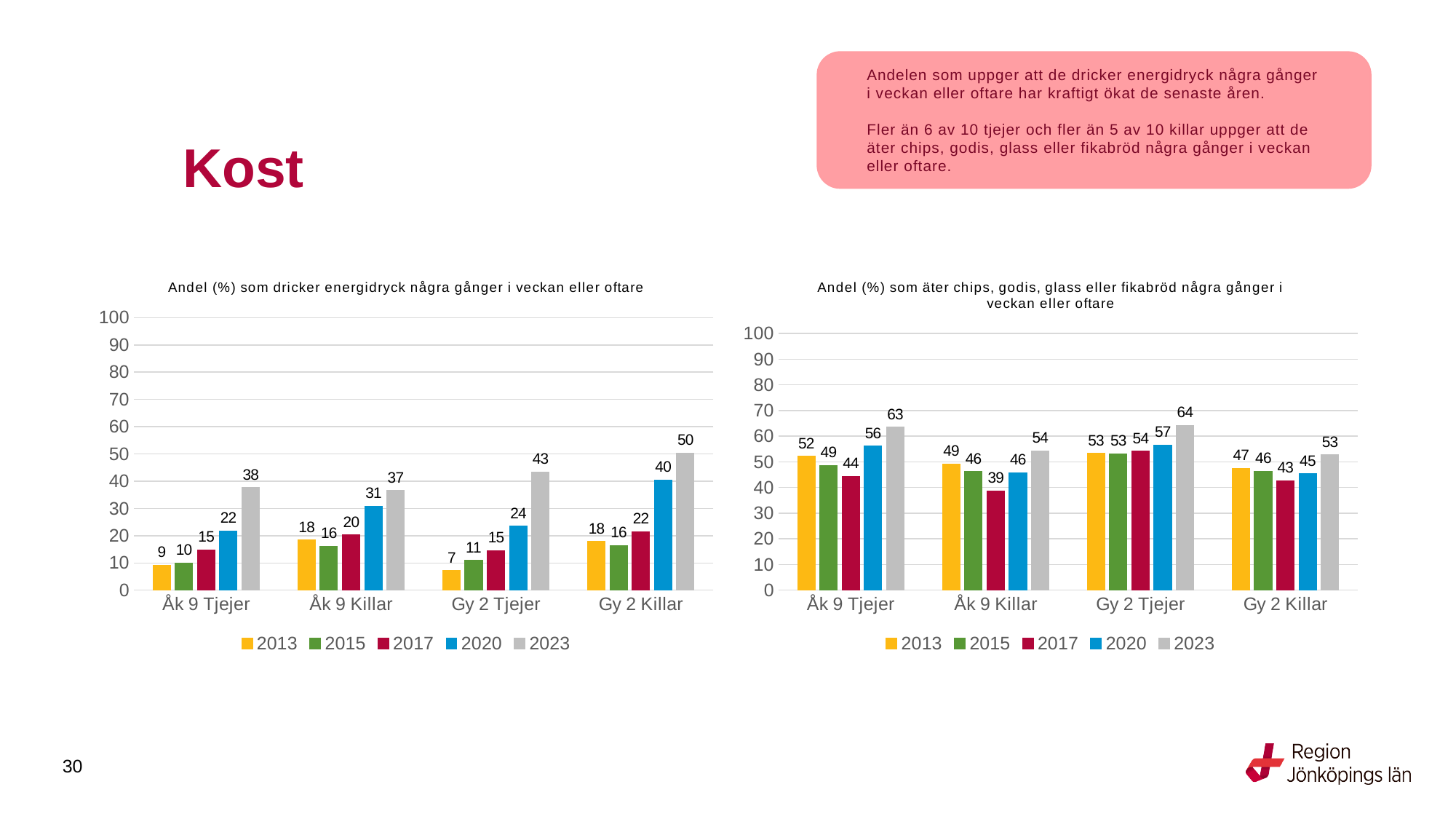
How many categories are shown on the x axis of the right chart? 4 In the left chart (energidryck), what is the value for Gy 2 Killar in 2023? 50 In the left chart (energidryck), what is the difference between the 2023 and 2020 values for Gy 2 Tjejer? 19 In the left chart (energidryck), which category has the lowest value for 2013? Gy 2 Tjejer What kind of chart is the left chart (energidryck)? Bar chart In the left chart (energidryck), which category has the highest value for 2023? Gy 2 Killar In the left chart (energidryck), what is the value for Åk 9 Tjejer in 2013? 9 How many series does the legend of the left chart list? 5 In the right chart (chips, godis, glass eller fikabröd), what is the difference between the 2023 and 2013 values for Åk 9 Tjejer? 11 In the right chart (chips, godis, glass eller fikabröd), what is the value for Åk 9 Killar in 2017? 39 In the right chart (chips, godis, glass eller fikabröd), which is larger for Gy 2 Killar: the 2013 value or the 2017 value? 2013 In the right chart (chips, godis, glass eller fikabröd), what is the value for Gy 2 Tjejer in 2023? 64